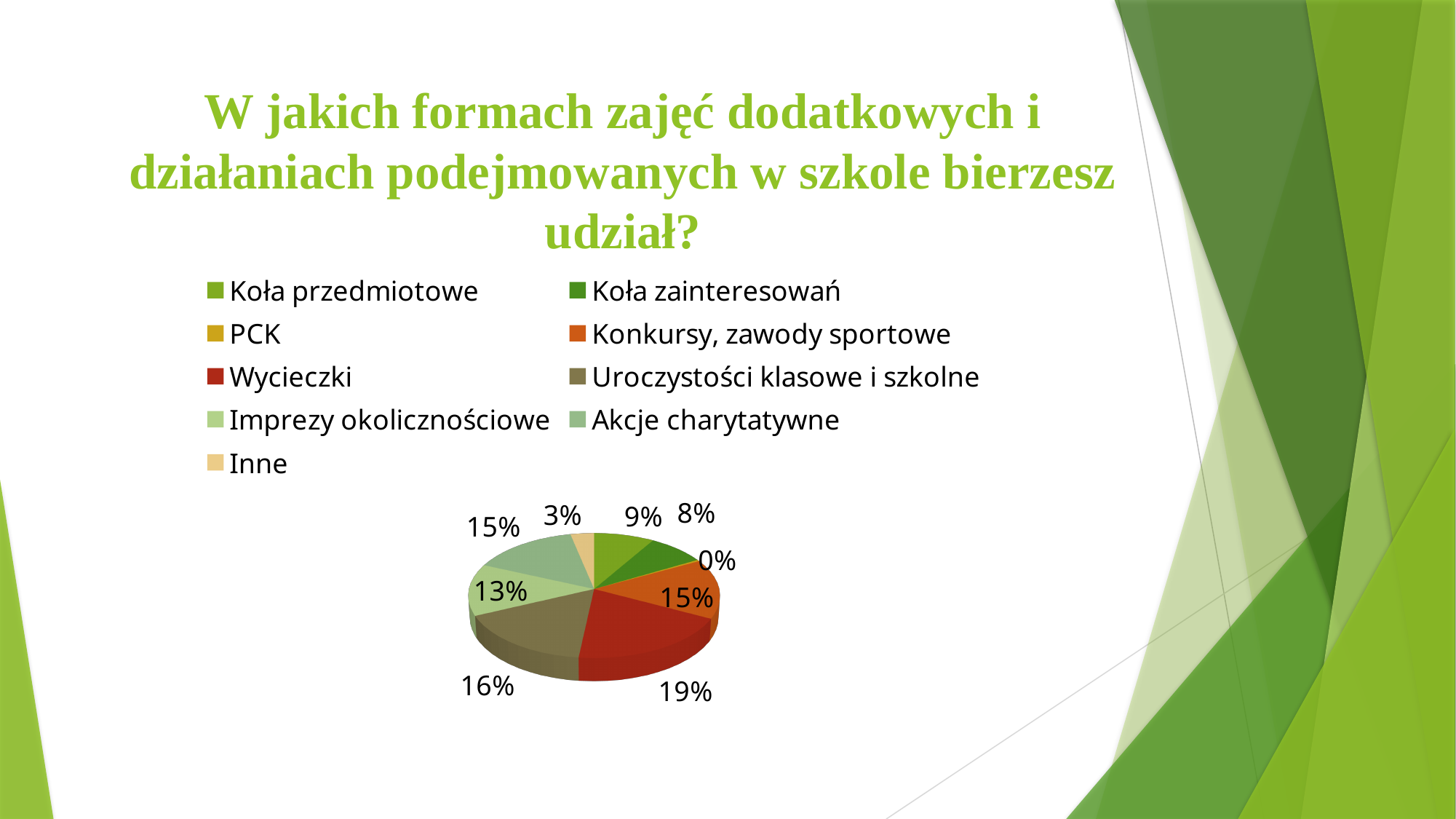
What percentage of the pie is PCK? 0% Which category has the largest share of the pie? Wycieczki What colour is the slice for Konkursy, zawody sportowe? orange Which is larger, the share for Koła przedmiotowe or the share for Koła zainteresowań? Koła przedmiotowe What percentage of the pie is Wycieczki? 19% Which category has the smallest share of the pie? PCK How many categories does the legend list? 9 What is the difference in percentage points between Wycieczki and Imprezy okolicznościowe? 6 What percentage of the pie is Koła przedmiotowe? 9% What kind of chart is shown on the slide? pie chart What percentage of the pie is Uroczystości klasowe i szkolne? 16% What percentage of the pie is Inne? 3%